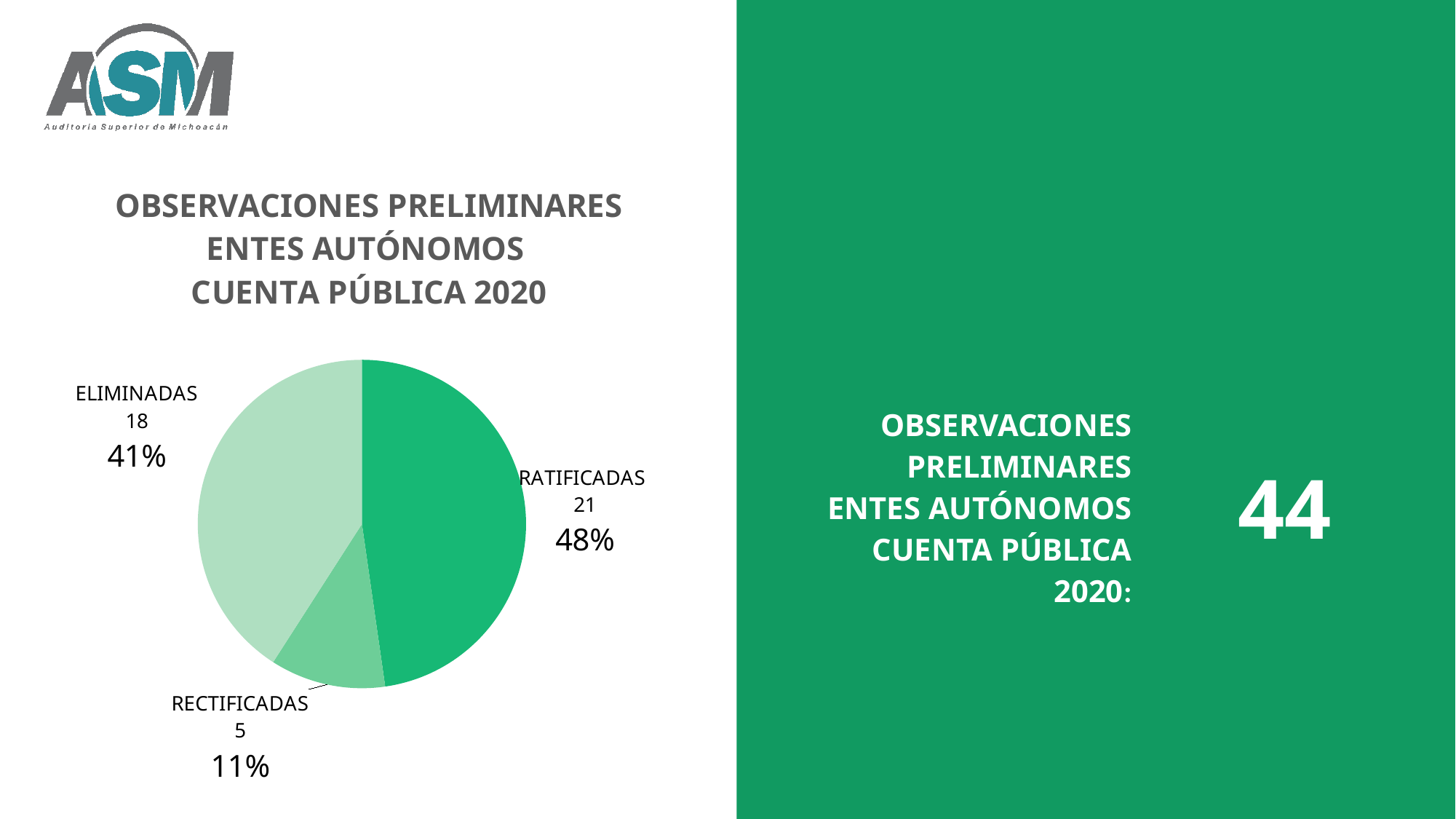
What is the value for RATIFICADAS? 21 Which category has the largest slice of the pie? RATIFICADAS Which is larger, the value for ELIMINADAS or the value for RECTIFICADAS? ELIMINADAS Which category has the smallest slice of the pie? RECTIFICADAS What type of chart is shown on the slide? pie chart What is the difference between the values for RATIFICADAS and ELIMINADAS? 3 What is the title of the chart? OBSERVACIONES PRELIMINARES ENTES AUTÓNOMOS CUENTA PÚBLICA 2020 What share of the pie does RECTIFICADAS represent? 11% How many slices does the pie chart have? 3 What is the value for RECTIFICADAS? 5 What is the value for ELIMINADAS? 18 What share of the pie does ELIMINADAS represent? 41%